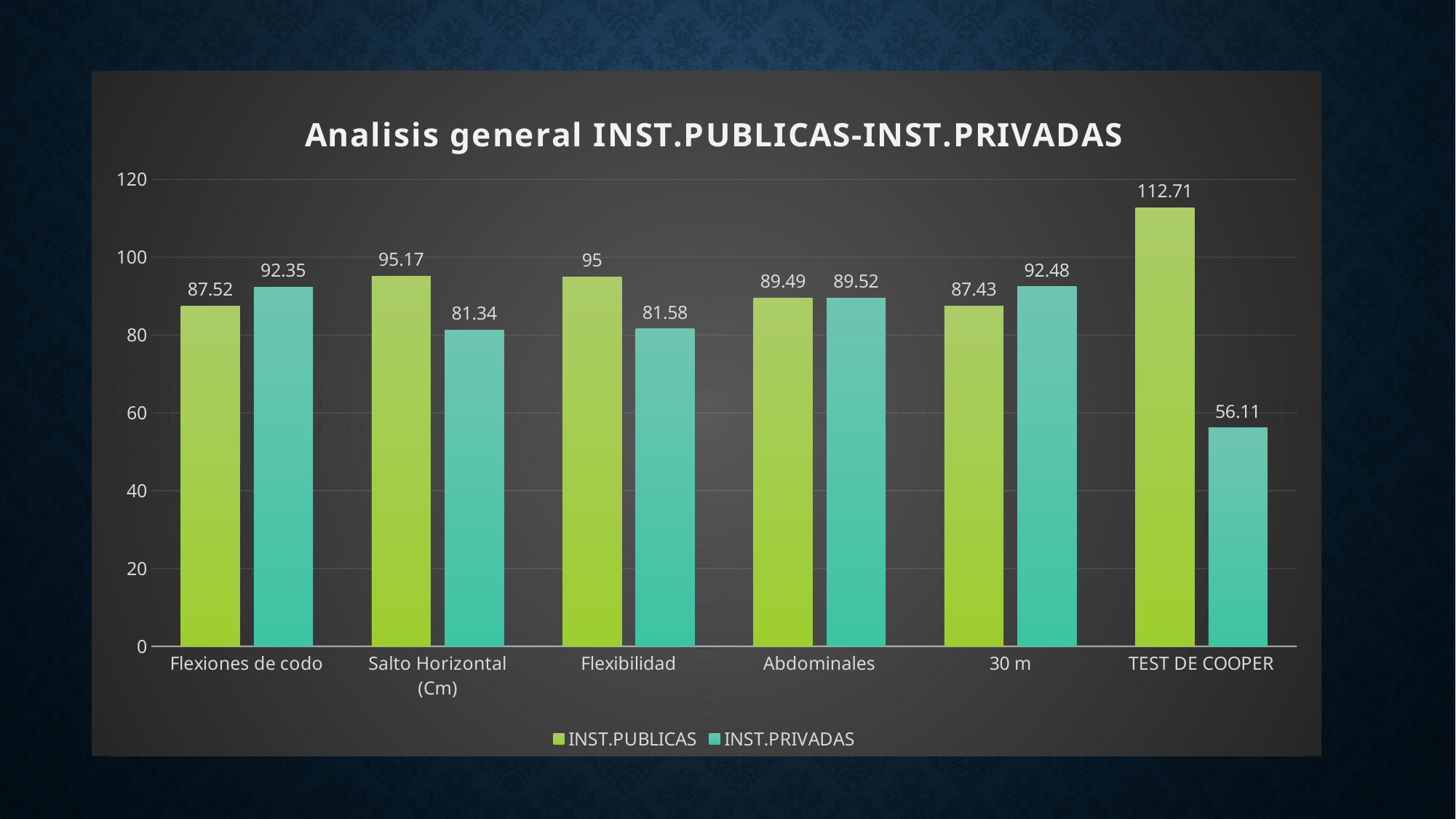
Which category has the lowest INST.PRIVADAS value? TEST DE COOPER What is the INST.PUBLICAS value for Flexibilidad? 95 What is the difference between the INST.PUBLICAS and INST.PRIVADAS values for TEST DE COOPER? 56.6 What is the difference between the INST.PUBLICAS and INST.PRIVADAS values for Flexiones de codo? 4.83 How many series does the legend list? 2 What is the INST.PRIVADAS value for Salto Horizontal (Cm)? 81.34 For 30 m, which series has the larger value, INST.PUBLICAS or INST.PRIVADAS? INST.PRIVADAS What type of chart is shown on the slide? Bar chart How many categories are shown on the x axis? 6 What is the INST.PRIVADAS value for TEST DE COOPER? 56.11 Is the INST.PUBLICAS value for TEST DE COOPER greater or less than 100? greater Which category has the highest INST.PUBLICAS value? TEST DE COOPER